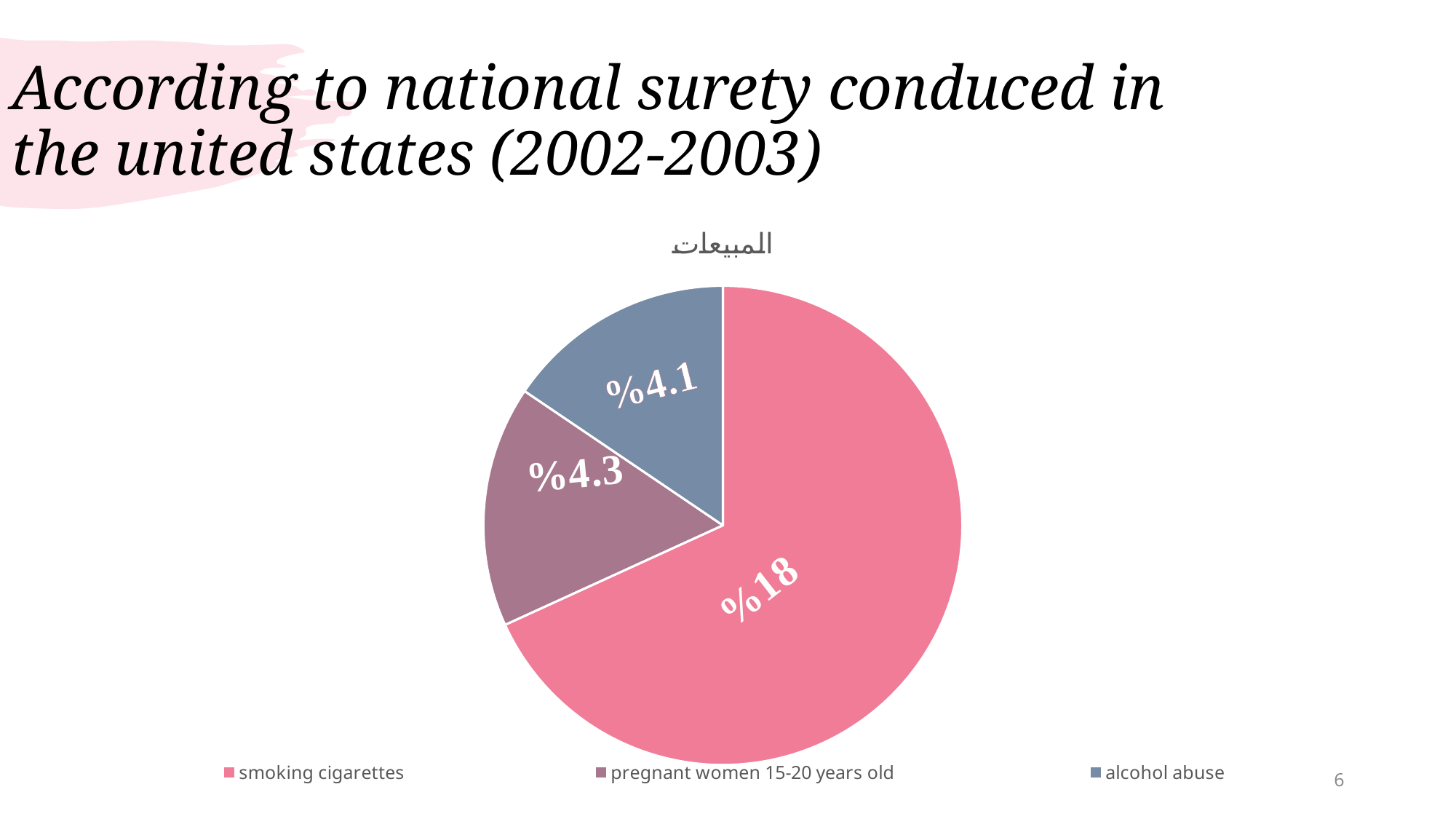
What value is shown for the alcohol abuse slice? %4.1 What is the difference between the smoking cigarettes value and the pregnant women 15-20 years old value? %13.7 Which is larger, the value for pregnant women 15-20 years old or the value for alcohol abuse? pregnant women 15-20 years old What value is shown for the smoking cigarettes slice? %18 Which category has the largest slice of the pie? smoking cigarettes How many slices does the pie chart have? 3 What colour is the smoking cigarettes slice? pink Which category has the smallest slice of the pie? alcohol abuse What is the difference between the pregnant women 15-20 years old value and the alcohol abuse value? %0.2 What kind of chart is shown on the slide? pie chart How many entries does the legend list? 3 What value is shown for the pregnant women 15-20 years old slice? %4.3